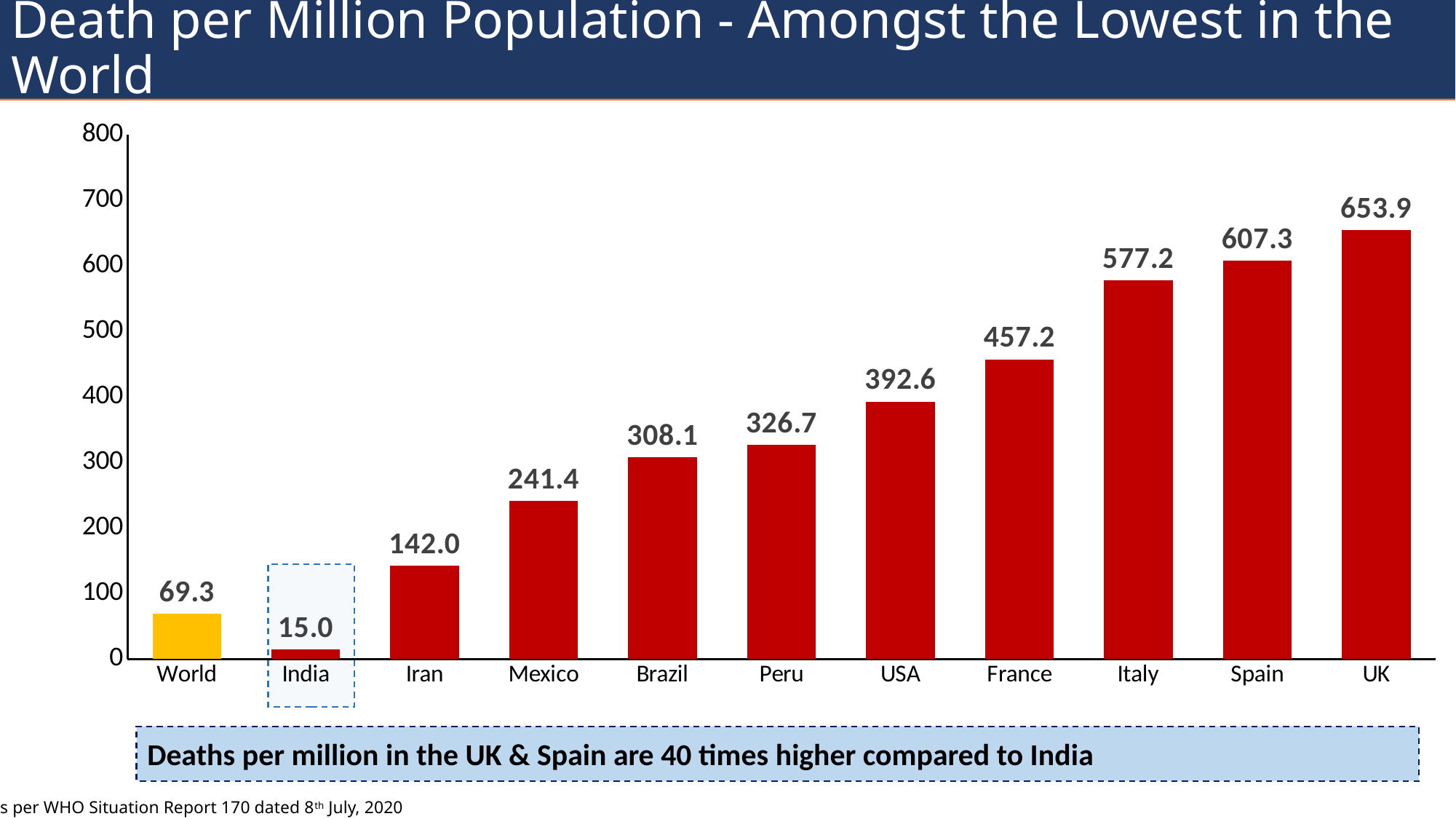
What is the death per million population value for the World? 69.3 How many categories are shown on the x axis of the chart? 11 Which category has the highest death per million population? UK What is the death per million population value for USA? 392.6 Which category has the lowest death per million population? India Which bar is coloured differently (yellow) from the rest? World What kind of chart is shown on the slide? Bar chart Which has a higher death per million population, Brazil or Peru? Peru Is the value for France greater or less than 400? greater What is the difference between the death per million values for Iran and India? 127.0 What is the difference between the death per million values for UK and Spain? 46.6 What is the death per million population value for India? 15.0